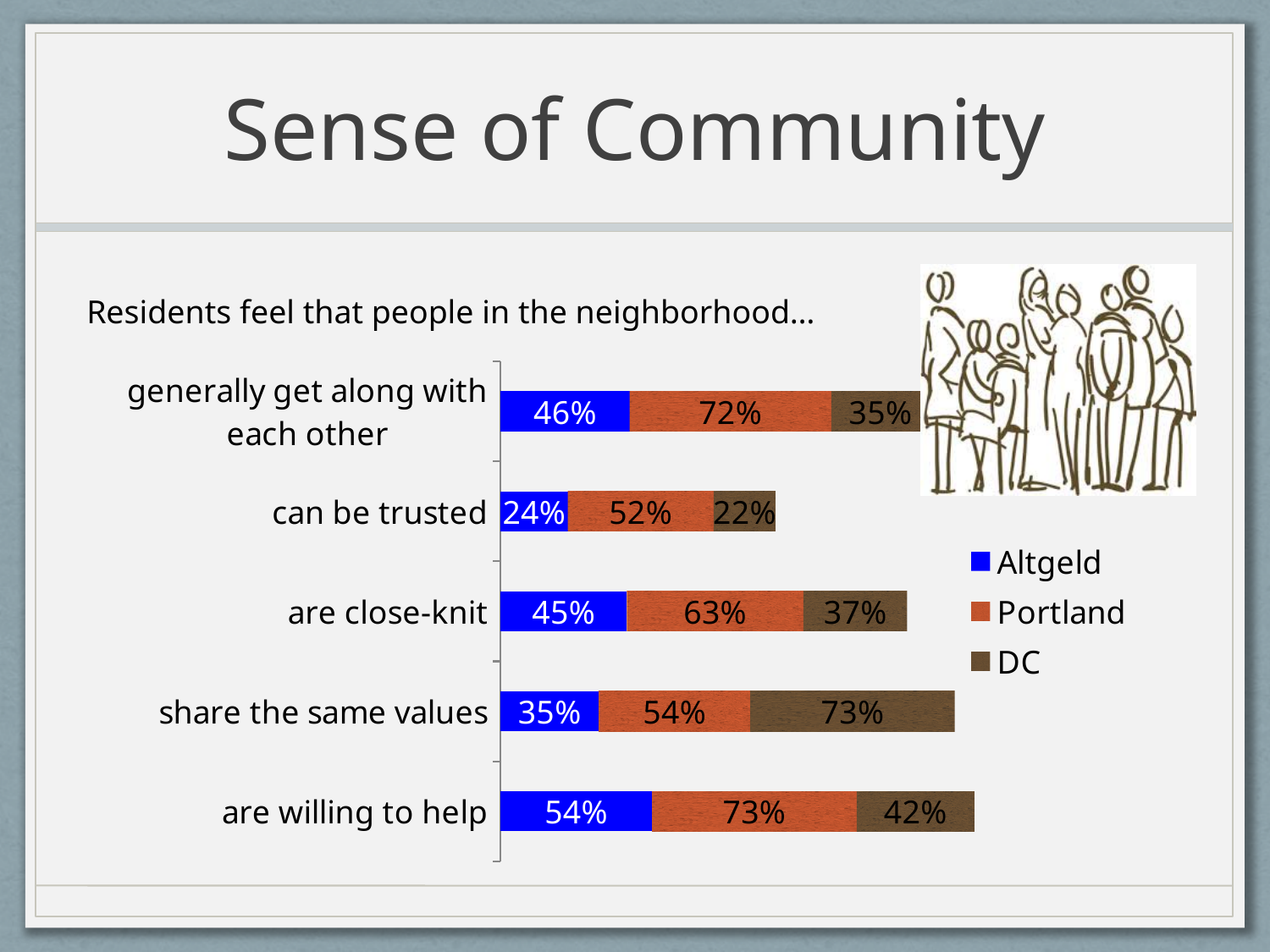
For 'are close-knit', which is larger: the Altgeld value or the DC value? Altgeld What is the total of the stacked bar for 'can be trusted'? 98% What is the DC value for 'share the same values'? 73% What kind of chart is shown on the slide? Stacked bar chart Which series is shown in blue in the legend? Altgeld What is the difference between the Portland and Altgeld values for 'generally get along with each other'? 26 percentage points How many series does the legend list? 3 What percentage of Altgeld residents feel that people in the neighborhood can be trusted? 24% What is the Portland value for 'are willing to help'? 73% For which category is the Altgeld value highest? are willing to help For which category is the DC value lowest? can be trusted How many categories are shown on the chart? 5